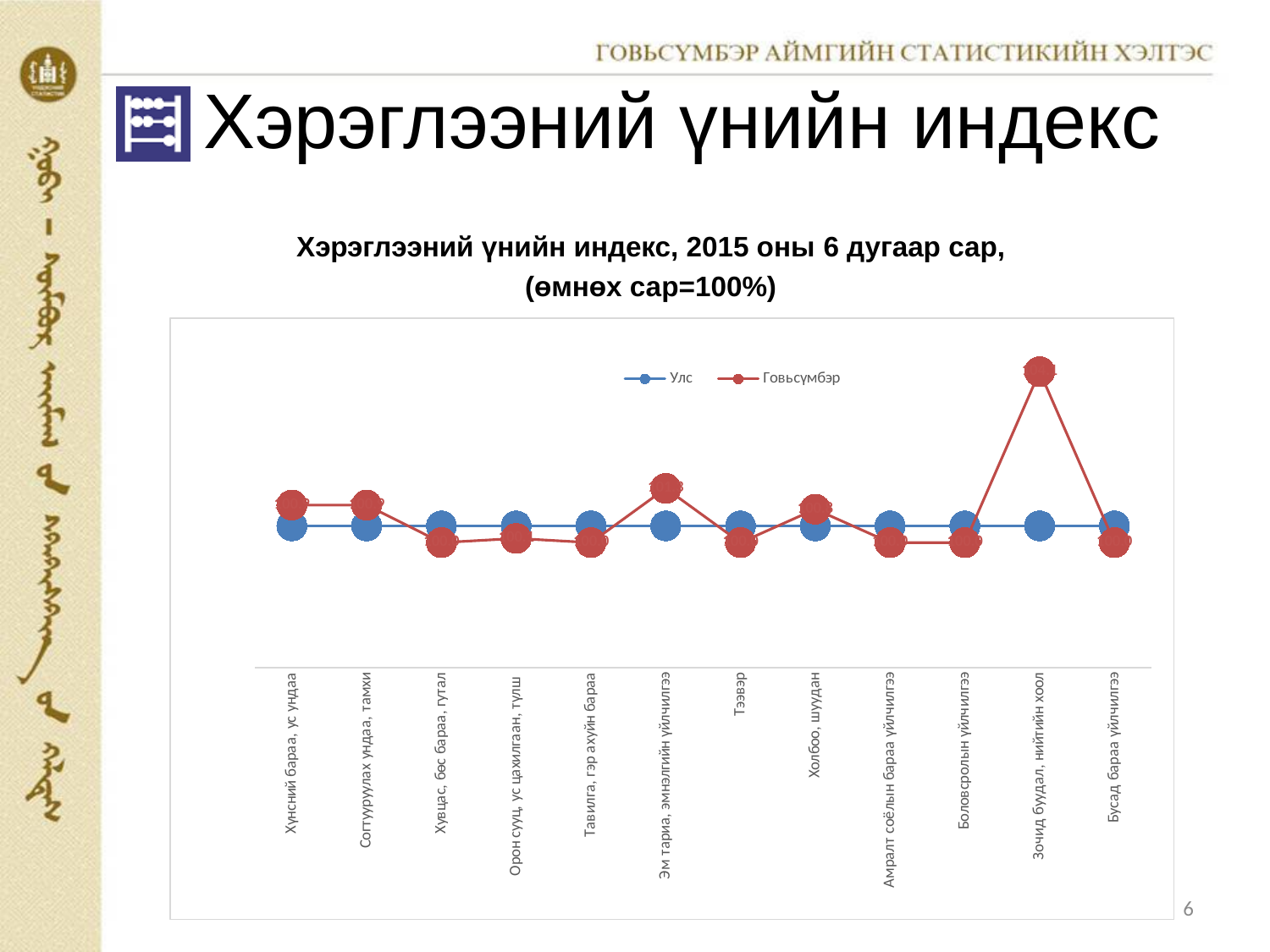
For the Говьсүмбэр series, which category has the highest value? Зочид буудал, нийтийн хоол How many series does the legend list? 2 For the category Зочид буудал, нийтийн хоол, which series has the larger value, Улс or Говьсүмбэр? Говьсүмбэр Which colour is used for the Говьсүмбэр series? Red What kind of chart is shown on the slide? Line chart What are the two series named in the legend? Улс and Говьсүмбэр Does the Улс series rise, fall, or stay flat across the categories? Stays flat How many categories are shown along the x axis? 12 For the category Хүнсний бараа, ус ундаа, which series has the larger value, Улс or Говьсүмбэр? Говьсүмбэр For the category Эм тариа, эмнэлгийн үйлчилгээ, which series has the larger value, Улс or Говьсүмбэр? Говьсүмбэр